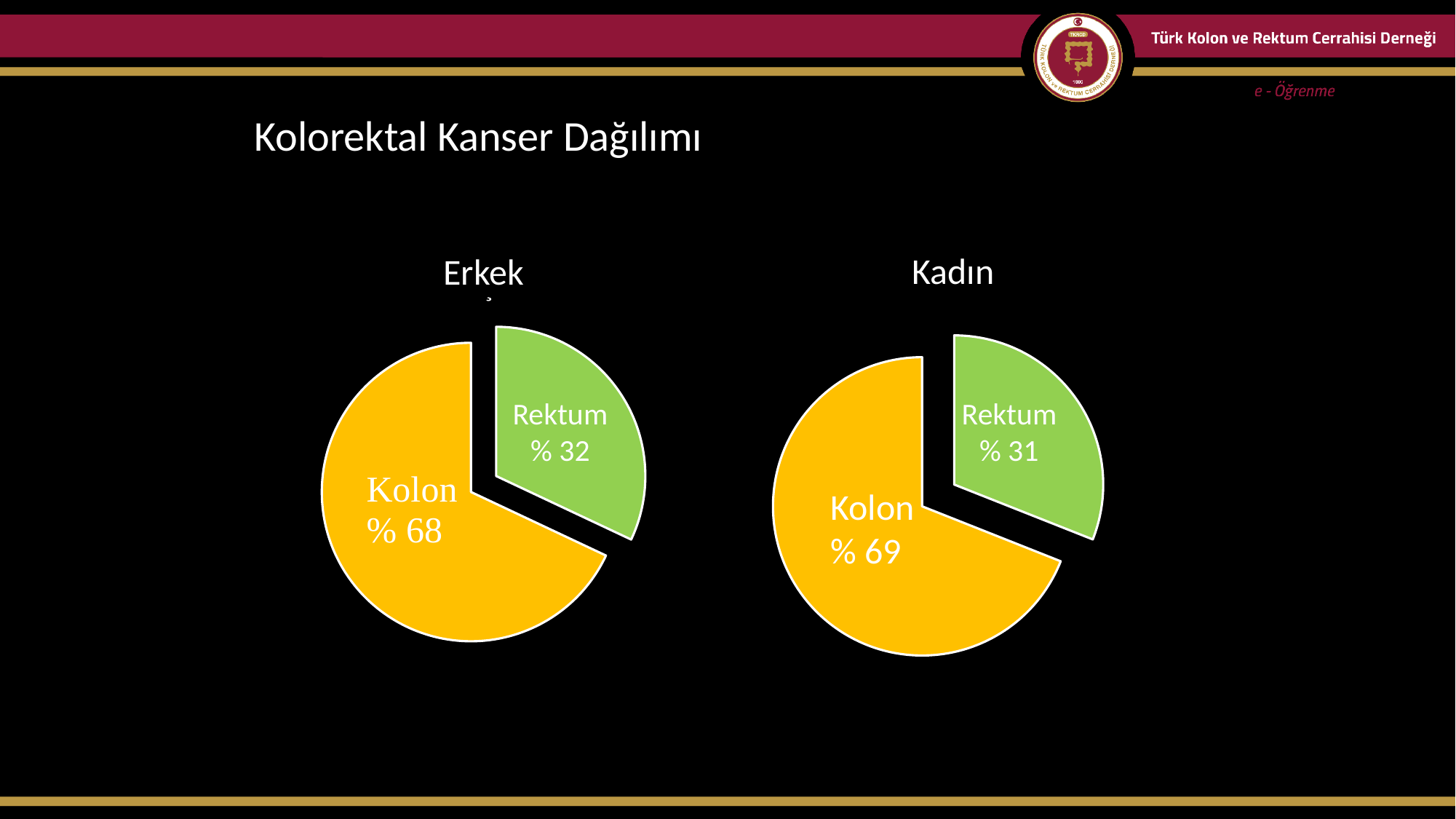
What is the title of the slide containing the two pie charts? Kolorektal Kanser Dağılımı Which is larger: Rektum in the Erkek chart or Rektum in the Kadın chart? Rektum in the Erkek chart What kind of chart is the Erkek chart? Pie chart In the Kadın pie chart, what is the value for Kolon? % 69 How many slices does the Kadın pie chart have? 2 In the Erkek pie chart, which slice is the largest? Kolon In the Erkek pie chart, what is the value for Kolon? % 68 In the Kadın pie chart, what is the difference between the Kolon and Rektum values? % 38 In the Kadın pie chart, which slice is the smallest? Rektum In the Kadın pie chart, what is the value for Rektum? % 31 In the Erkek pie chart, what is the difference between the Kolon and Rektum values? % 36 In the Erkek pie chart, what is the value for Rektum? % 32